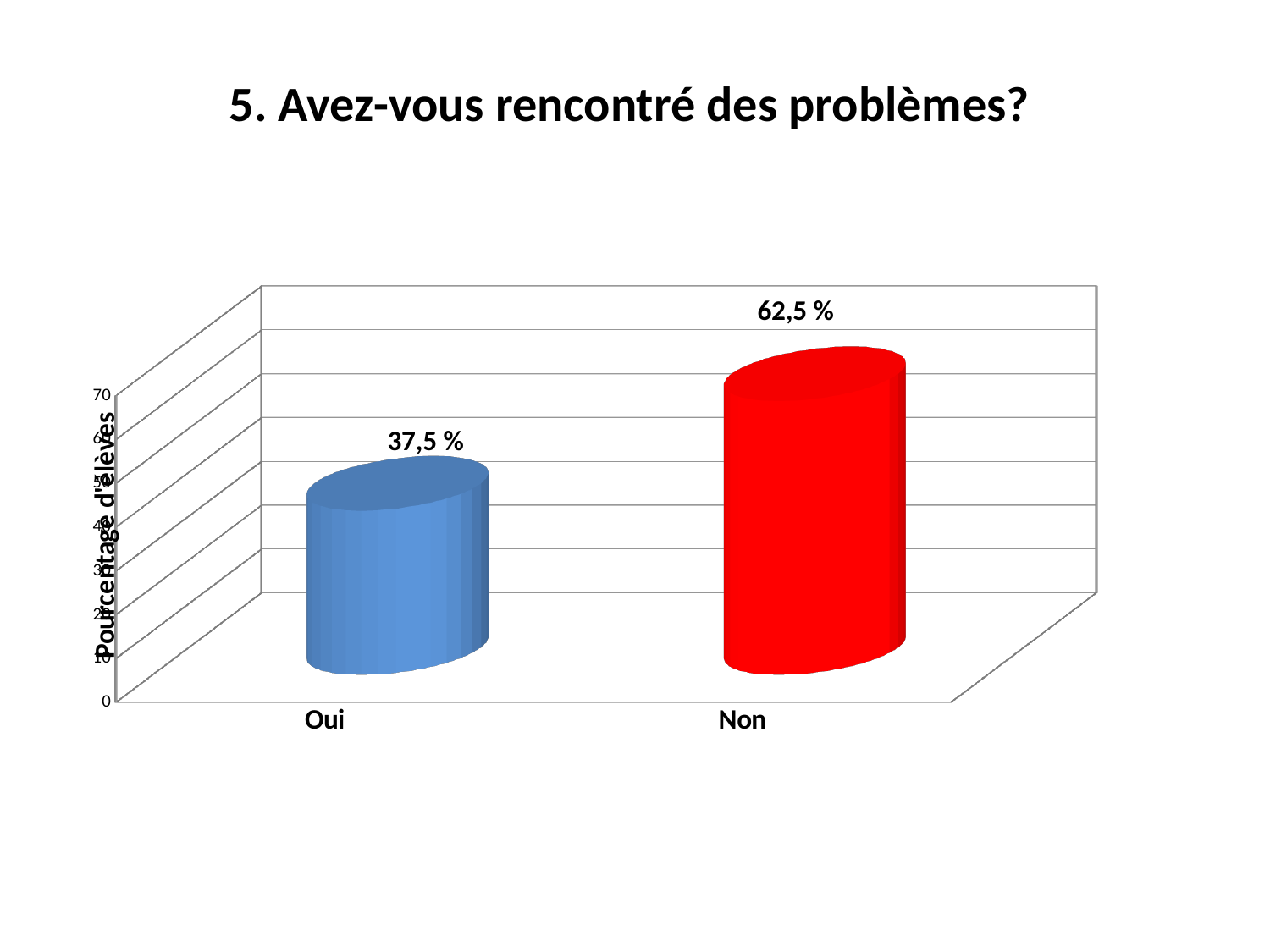
Which category has the lowest value? Oui What colour is the bar for Non? red Is the value for Non greater or less than 50? greater What is the value for Oui? 37,5 % How many categories are shown on the x axis? 2 Is the value for Oui greater or less than 40? less What is the title of the slide? 5. Avez-vous rencontré des problèmes? Which category has the highest value? Non What is the difference between the values for Non and Oui? 25 % What kind of chart is shown on the slide? bar chart What is the value for Non? 62,5 % Which is larger, the value for Oui or the value for Non? Non